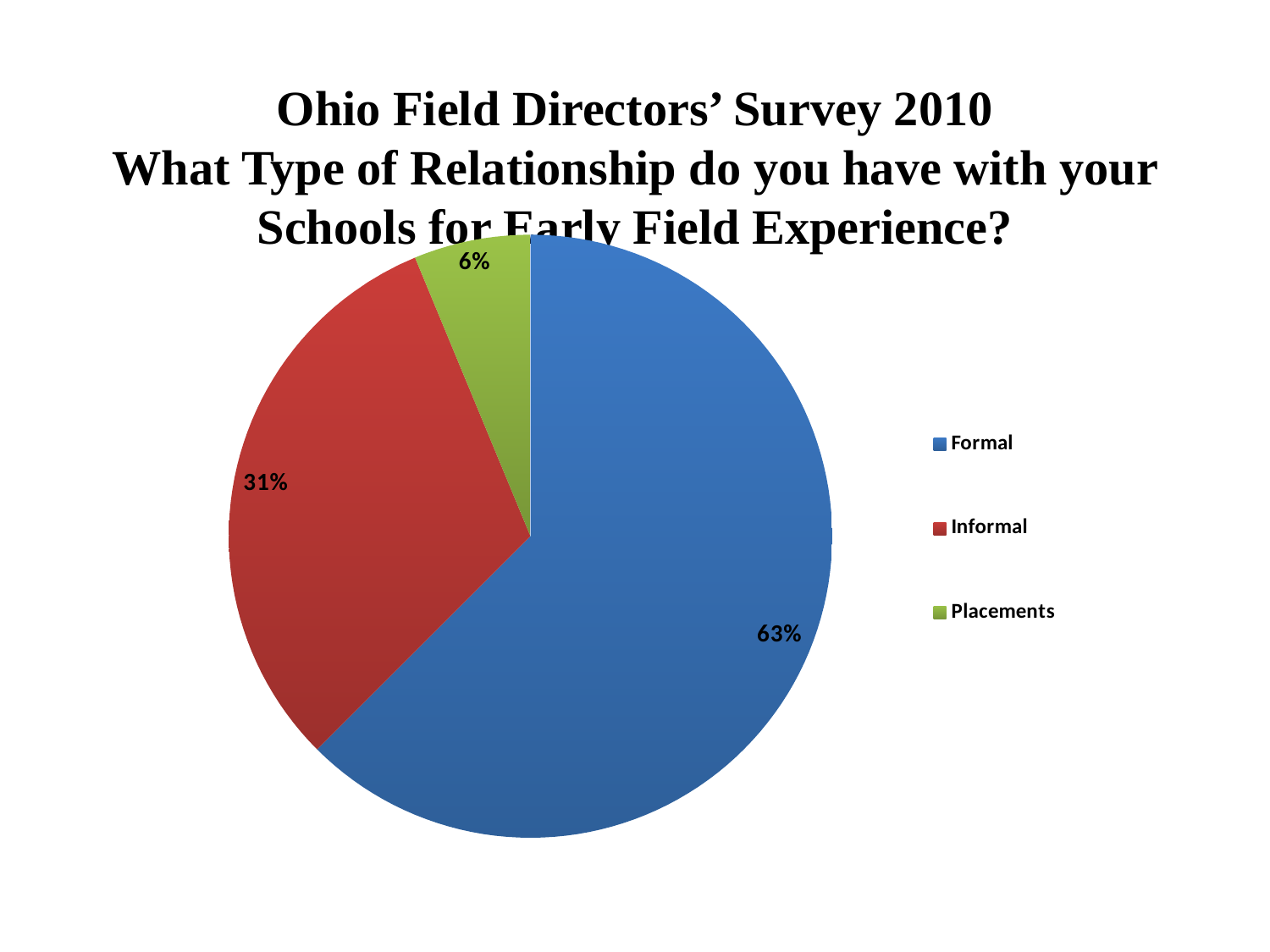
Which category has the smallest share of the pie? Placements What is the difference in percentage points between Informal and Placements? 25 What is the difference in percentage points between Formal and Informal? 32 What percentage of respondents reported an Informal relationship? 31% What kind of chart is shown on the slide? Pie chart Which category has the largest share of the pie? Formal What survey year is given in the chart title? 2010 What percentage of respondents reported a Formal relationship? 63% How many categories are shown in the pie chart? 3 What percentage of respondents reported Placements? 6% What colour represents the Informal category? Red Which is larger, the Informal share or the Placements share? Informal